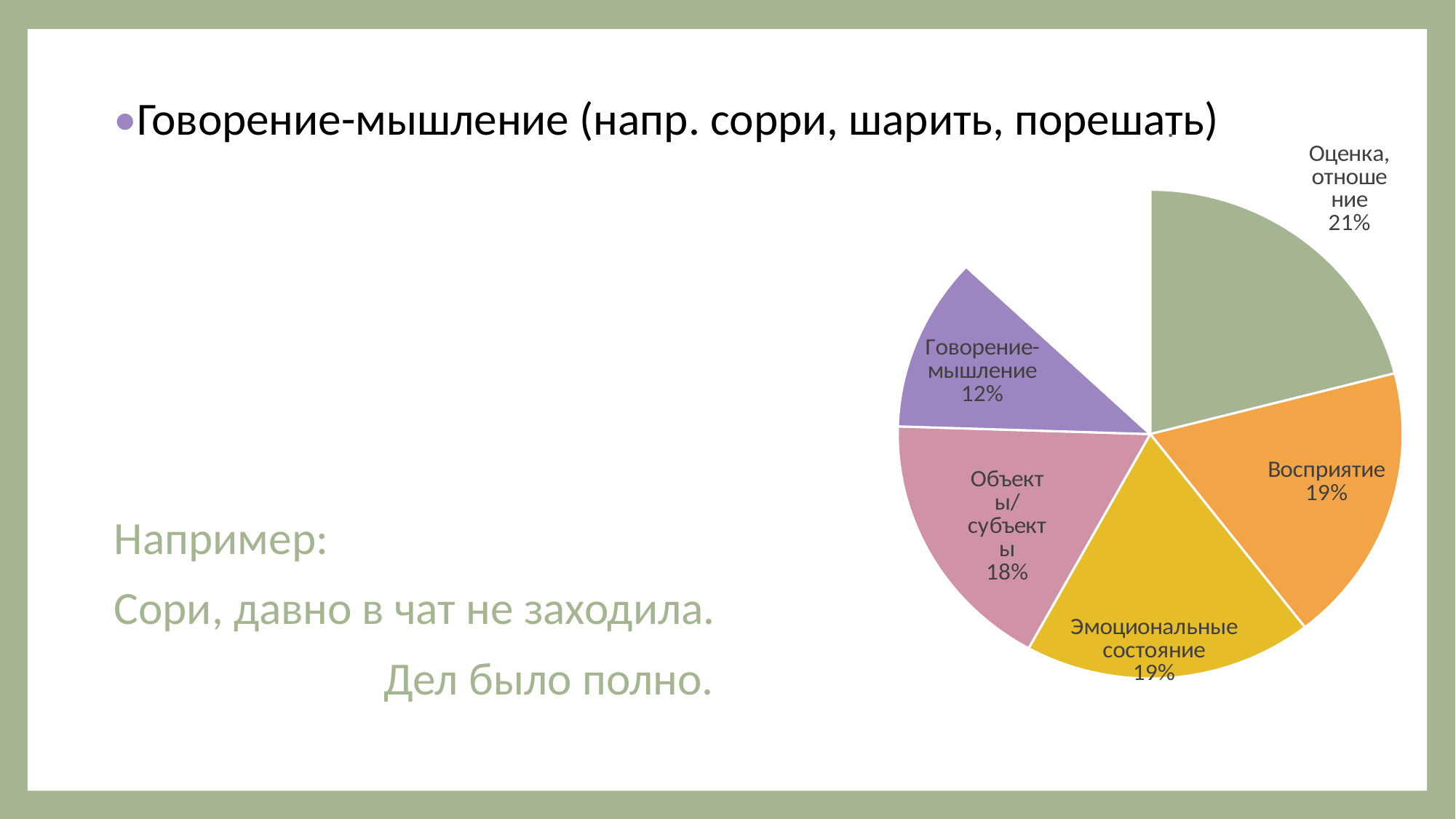
What percentage is shown for "Восприятие" in the pie chart? 19% What is the difference in percentage points between "Оценка, отношение" and "Говорение-мышление"? 9 What percentage is shown for "Объекты/субъекты" in the pie chart? 18% How many labeled slices does the pie chart have? 5 What percentage is shown for "Говорение-мышление" in the pie chart? 12% Which labeled slice of the pie chart has the smallest share? Говорение-мышление What percentage is shown for "Эмоциональные состояние" in the pie chart? 19% What share of the pie chart does the "Оценка, отношение" slice represent? 21% Which is larger in the pie chart: "Оценка, отношение" or "Объекты/субъекты"? Оценка, отношение What colour is the "Говорение-мышление" slice in the pie chart? Purple What type of chart is shown on the slide? Pie chart Which labeled slice of the pie chart has the largest share? Оценка, отношение